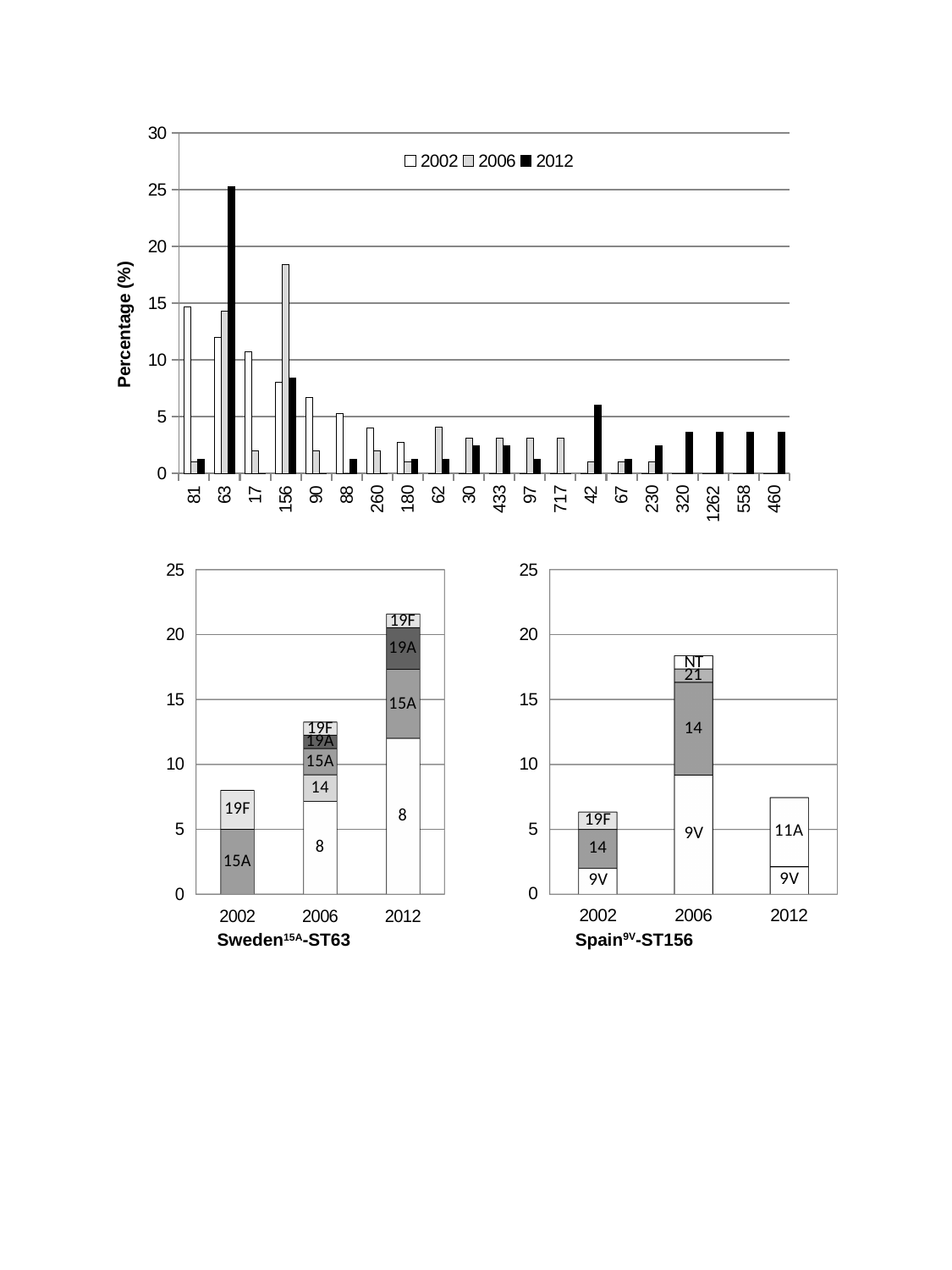
In the top chart, is the 2012 value for 63 greater or less than 20? greater In the Spain9V-ST156 chart, is the total for 2012 greater or less than 10? less In the top chart, is the 2006 value for 156 greater or less than 15? greater In the top chart, how many series does the legend list? 3 In the Sweden15A-ST63 chart, do the bar totals rise or fall from 2002 to 2012? rise In the Spain9V-ST156 chart, which segments make up the 2012 bar? 9V and 11A In the top chart, how many categories are shown on the x axis? 20 What kind of chart is the Sweden15A-ST63 chart? Stacked bar chart In the top chart, which is larger for category 63: the 2002 value or the 2012 value? 2012 In the top chart, which category has the highest 2012 value? 63 In the top chart, which category has the highest 2006 value? 156